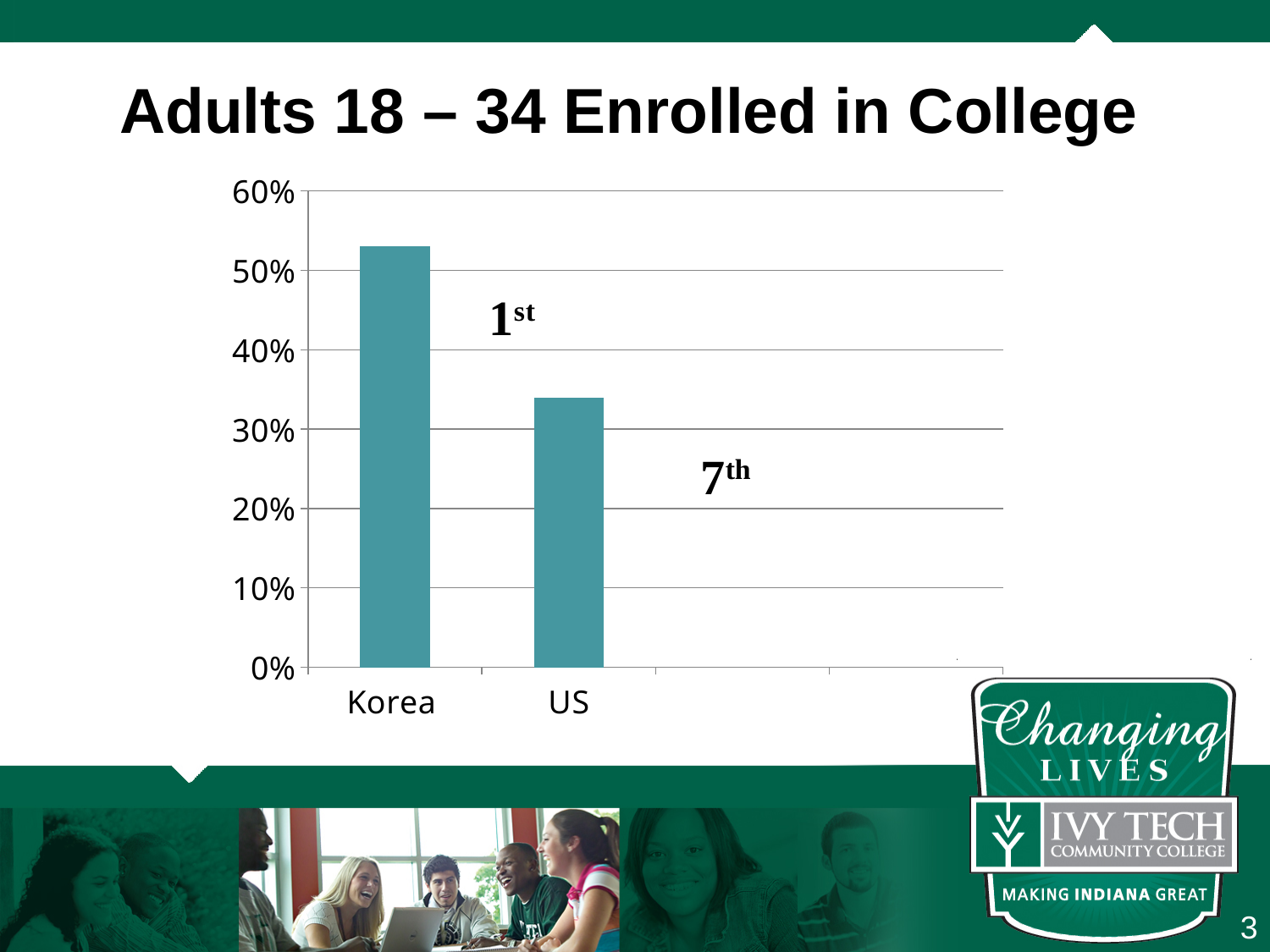
What is the title of the slide containing the chart? Adults 18 – 34 Enrolled in College Is the value for US greater or less than 30%? greater Which category has the lowest value? US How many categories are plotted in the chart? 2 Is the value for Korea greater or less than 60%? less Which category has the highest value? Korea Is the value for Korea greater or less than 50%? greater Which is larger, the value for Korea or the value for US? Korea What kind of chart is shown on the slide? bar chart What ranking label is printed next to the US bar? 7th